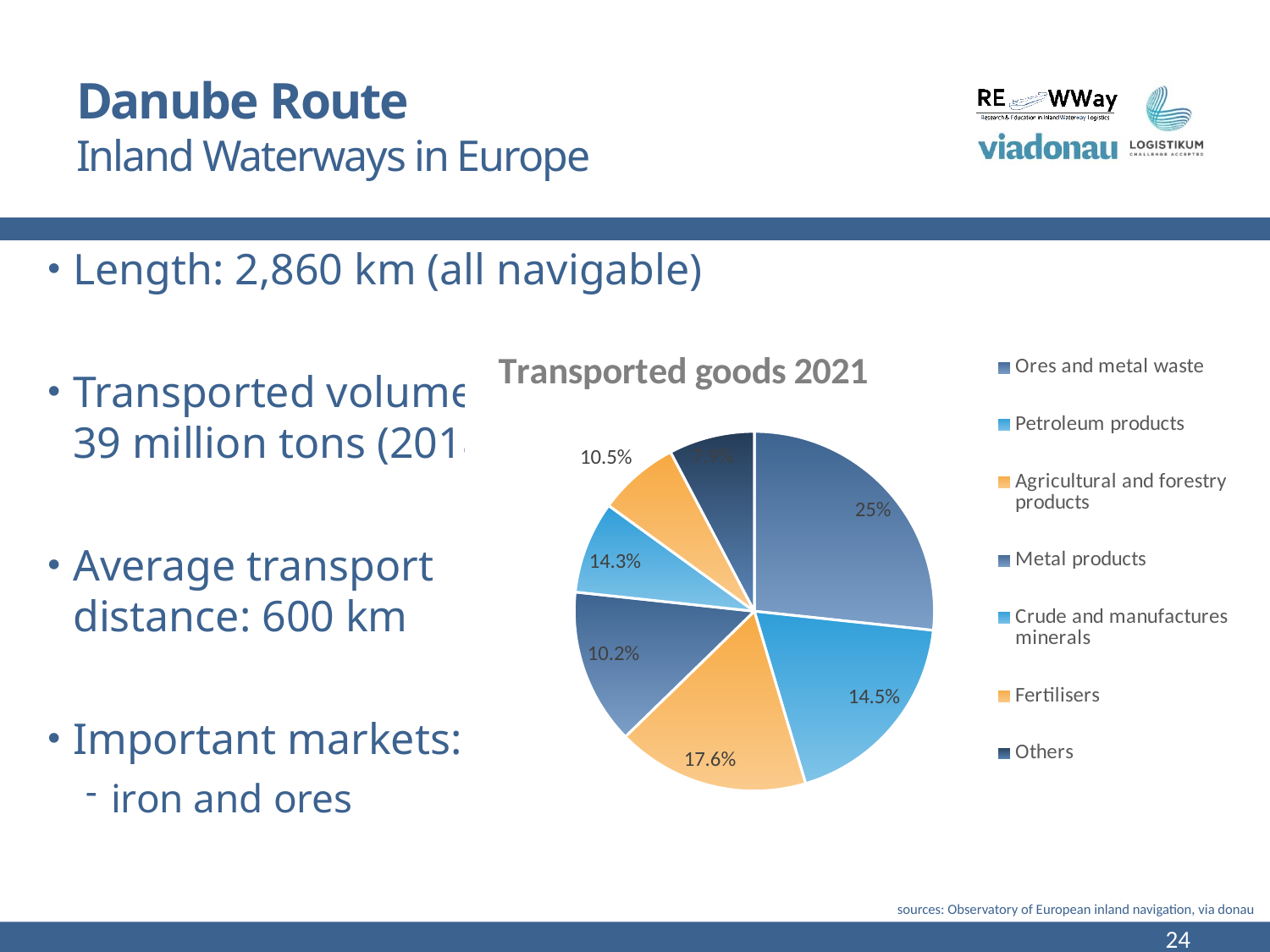
What share of transported goods in 2021 is Petroleum products? 14.5% What share of transported goods in 2021 is Agricultural and forestry products? 17.6% Which has the larger share: Agricultural and forestry products or Petroleum products? Agricultural and forestry products How many categories does the legend of the pie chart list? 7 What share of transported goods in 2021 is Ores and metal waste? 25% What kind of chart is shown on the slide? pie chart What share of transported goods in 2021 is Metal products? 10.2% What share of transported goods in 2021 is Crude and manufactures minerals? 14.3% By how many percentage points does the share of Ores and metal waste exceed that of Agricultural and forestry products? 7.4 percentage points What share of transported goods in 2021 is Fertilisers? 10.5% What is the title of the chart? Transported goods 2021 Which category has the largest share of transported goods in 2021? Ores and metal waste